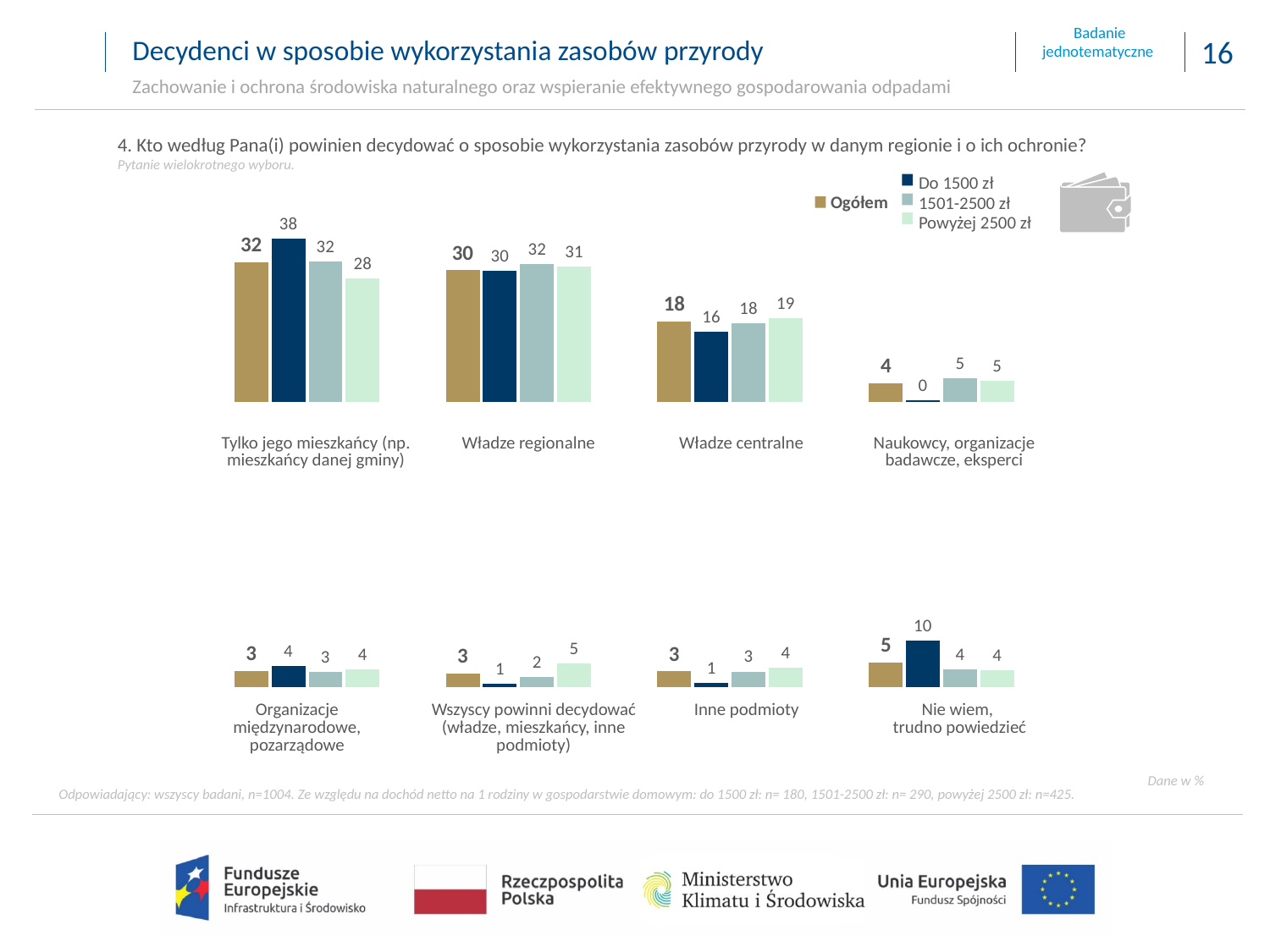
What kind of chart is shown on the slide? Bar chart What is the value for the "Do 1500 zł" series in the "Nie wiem, trudno powiedzieć" category? 10 How many categories are shown in the chart? 8 What is the difference between the Ogółem values for "Władze regionalne" and "Władze centralne"? 12 Which is larger for "Wszyscy powinni decydować (władze, mieszkańcy, inne podmioty)": the "Do 1500 zł" value or the "Powyżej 2500 zł" value? Powyżej 2500 zł Which category has the highest Ogółem value? Tylko jego mieszkańcy (np. mieszkańcy danej gminy) What is the difference between the "Do 1500 zł" and "Powyżej 2500 zł" values for "Tylko jego mieszkańcy (np. mieszkańcy danej gminy)"? 10 What is the value for the "Powyżej 2500 zł" series in the "Władze centralne" category? 19 How many series does the legend list? 4 What is the value for the "Do 1500 zł" series in the "Naukowcy, organizacje badawcze, eksperci" category? 0 What is the Ogółem value for "Tylko jego mieszkańcy (np. mieszkańcy danej gminy)"? 32 Which series has the lowest value in the "Tylko jego mieszkańcy (np. mieszkańcy danej gminy)" category? Powyżej 2500 zł